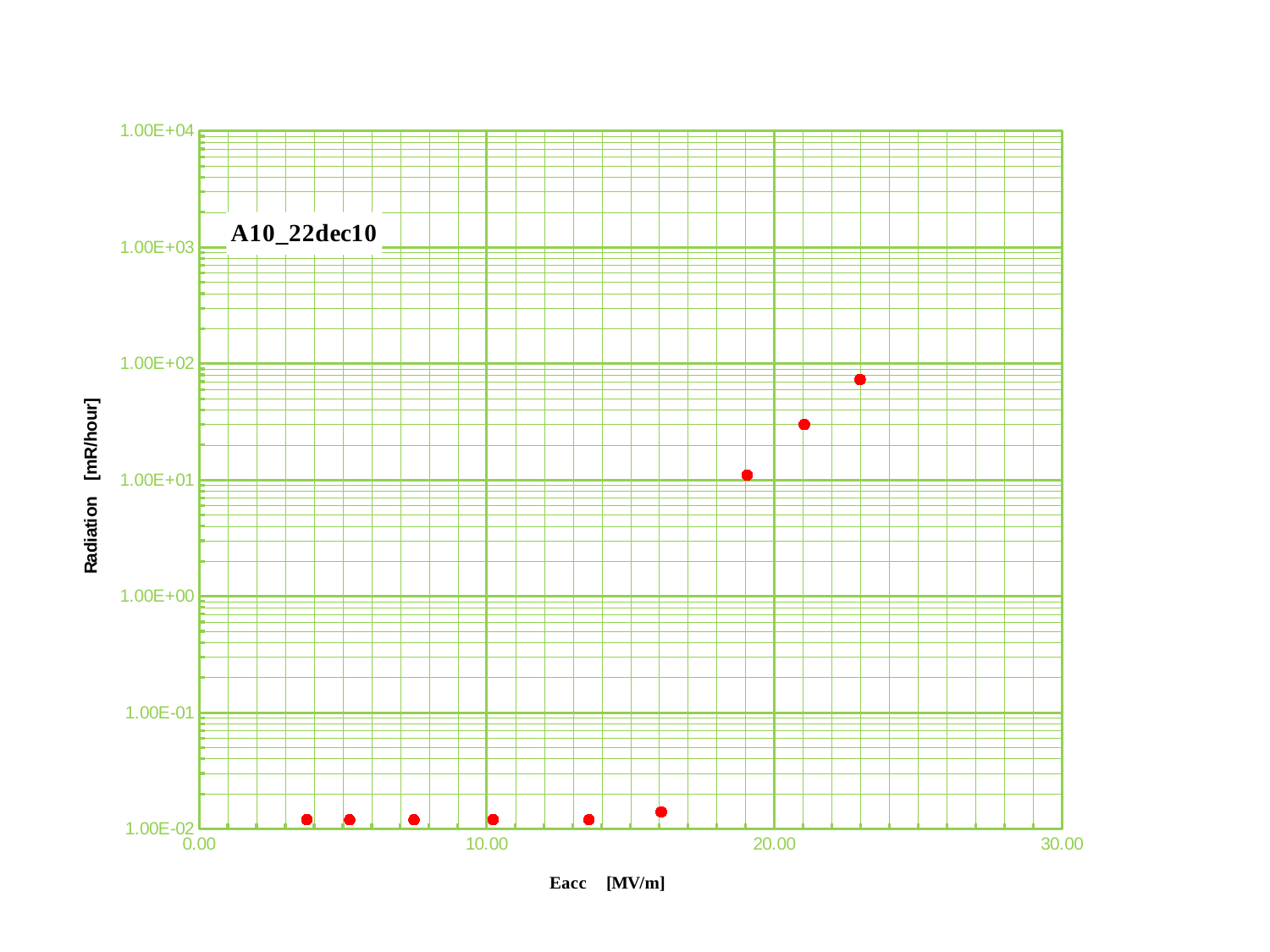
Is the radiation value of the data point just right of 20.00 MV/m greater or less than 1.00E+01? greater What is the label of the y axis? Radiation [mR/hour] Which has the higher radiation value: the rightmost data point or the leftmost data point? the rightmost data point What kind of chart is shown on the slide? scatter chart Is the radiation value of the data point at about 10.00 MV/m greater or less than 1.00E-01? less Is the radiation value of the rightmost data point greater or less than 1.00E+02? less Do the radiation values rise or fall as Eacc increases along the x axis? rise How many data points are plotted on the chart? 9 What is the title shown on the chart? A10_22dec10